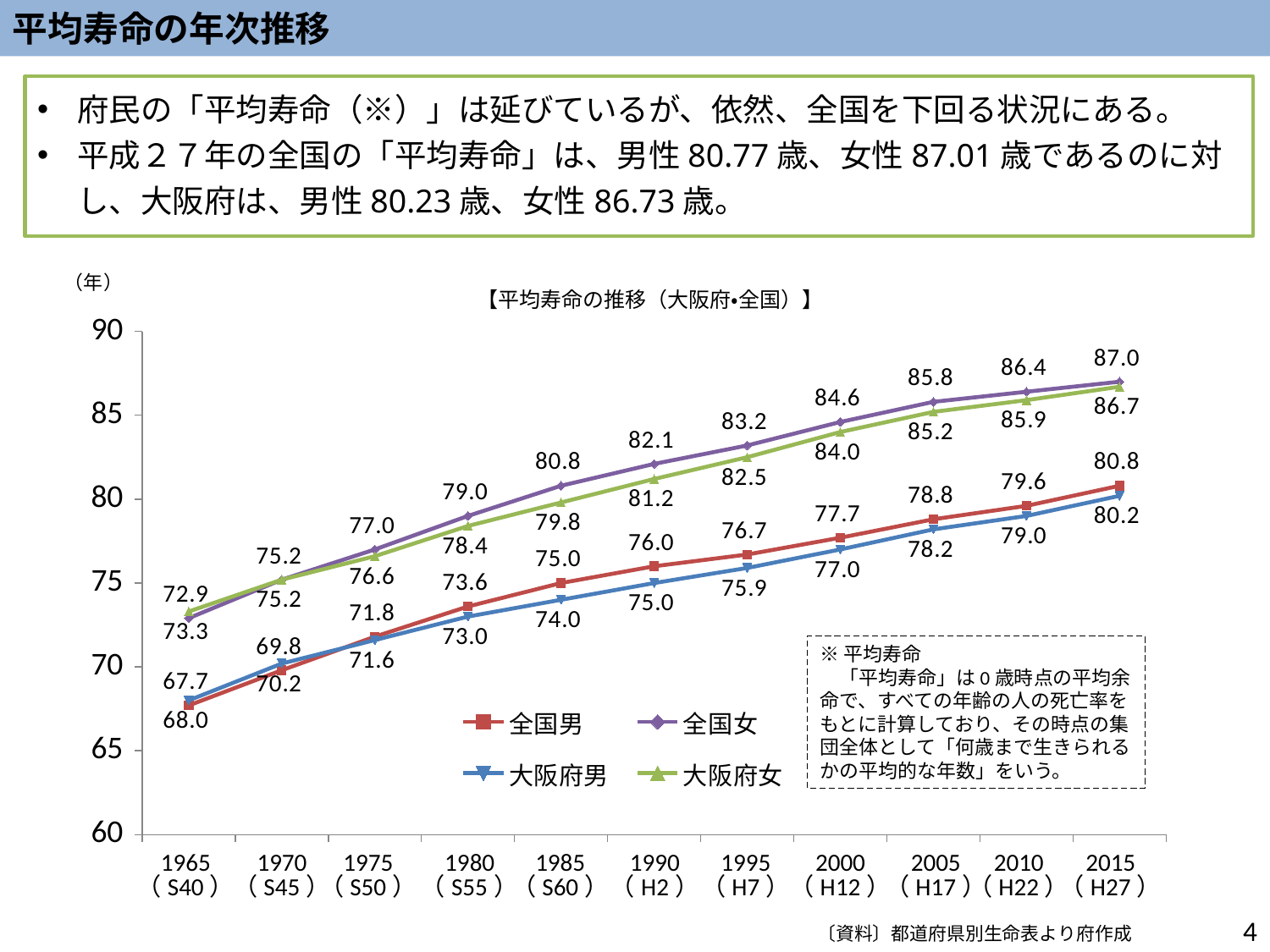
What kind of chart is shown on the slide? line chart What is the value for 大阪府女 in 1990 (H2)? 81.2 What is the difference between 全国女 and 大阪府女 in 2015 (H27)? 0.3 What is the value for 全国男 in 2000 (H12)? 77.7 What is the value for 大阪府男 in 2015 (H27)? 80.2 How many series does the chart legend list? 4 What is the value for 全国女 in 2015 (H27)? 87.0 How many years are plotted along the x axis of the chart? 11 In 2010 (H22), which is larger, 全国男 or 大阪府男? 全国男 Do the values for 大阪府女 rise or fall from 1965 to 2015? rise By how much did 全国男 increase from 1985 (S60) to 2015 (H27)? 5.8 Which series has the highest value in 2015 (H27)? 全国女